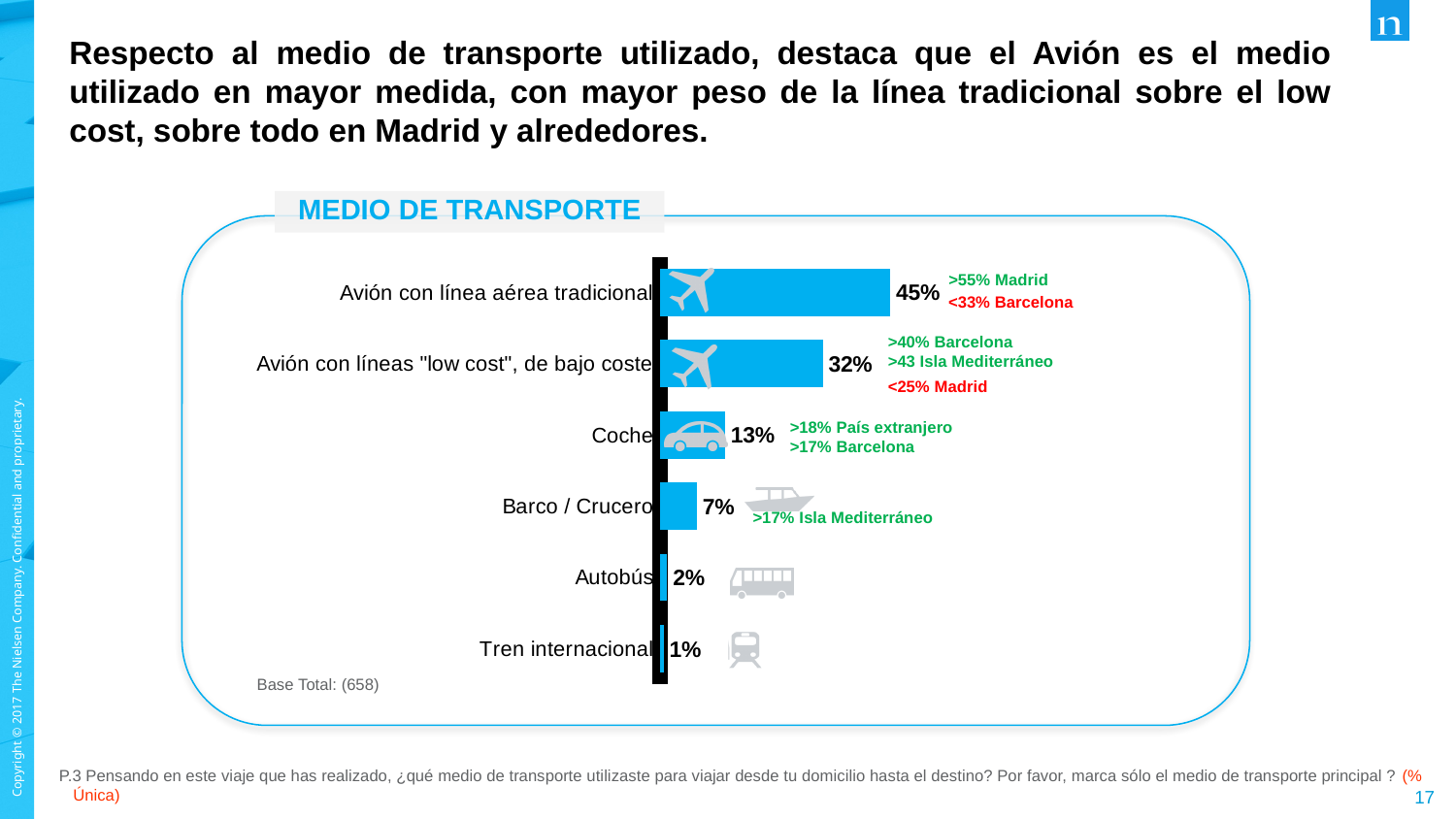
What is the value for Avión con líneas "low cost", de bajo coste? 32% What is the value for Tren internacional? 1% What is the value for Barco / Crucero? 7% How many categories are shown in the chart? 6 Which category has the lowest value? Tren internacional Which category has the highest value? Avión con línea aérea tradicional What is the title of the chart? MEDIO DE TRANSPORTE What is the value for Avión con línea aérea tradicional? 45% What is the difference between Avión con línea aérea tradicional and Avión con líneas "low cost", de bajo coste? 13% What is the value for Coche? 13% What kind of chart is shown? Bar chart Which is larger, Coche or Barco / Crucero? Coche